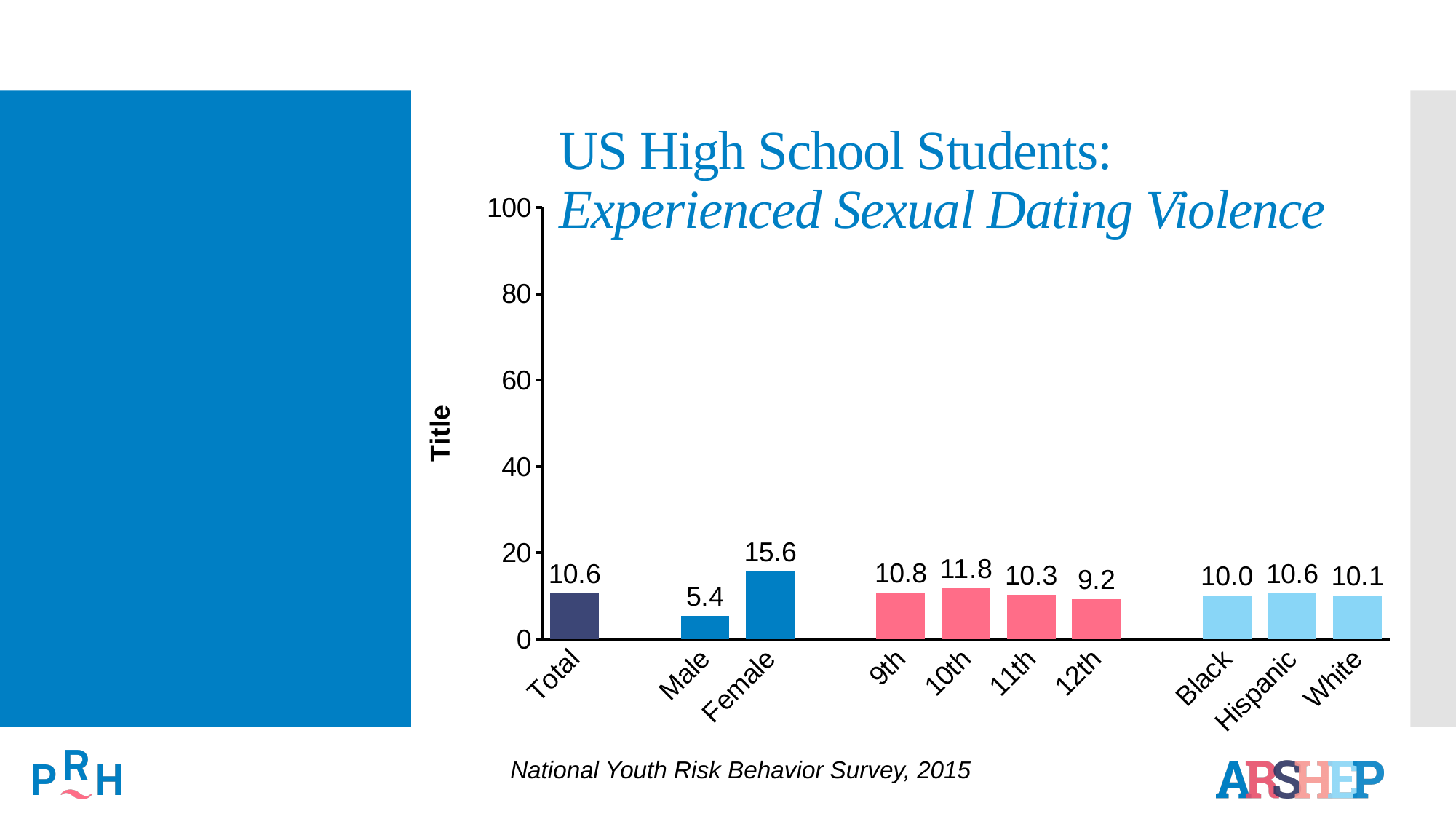
Which is larger, the value for 9th or the value for 12th? 9th What is the value for Male? 5.4 What is the difference between the Female and Male values? 10.2 Which category has the highest value? Female What is the value for 10th? 11.8 What kind of chart is shown? bar chart Is the value for Female greater or less than 20? less Which category has the lowest value? Male What is the value for Female? 15.6 How many categories are shown on the x axis? 10 What is the value for Hispanic? 10.6 What is the title of the chart? US High School Students: Experienced Sexual Dating Violence